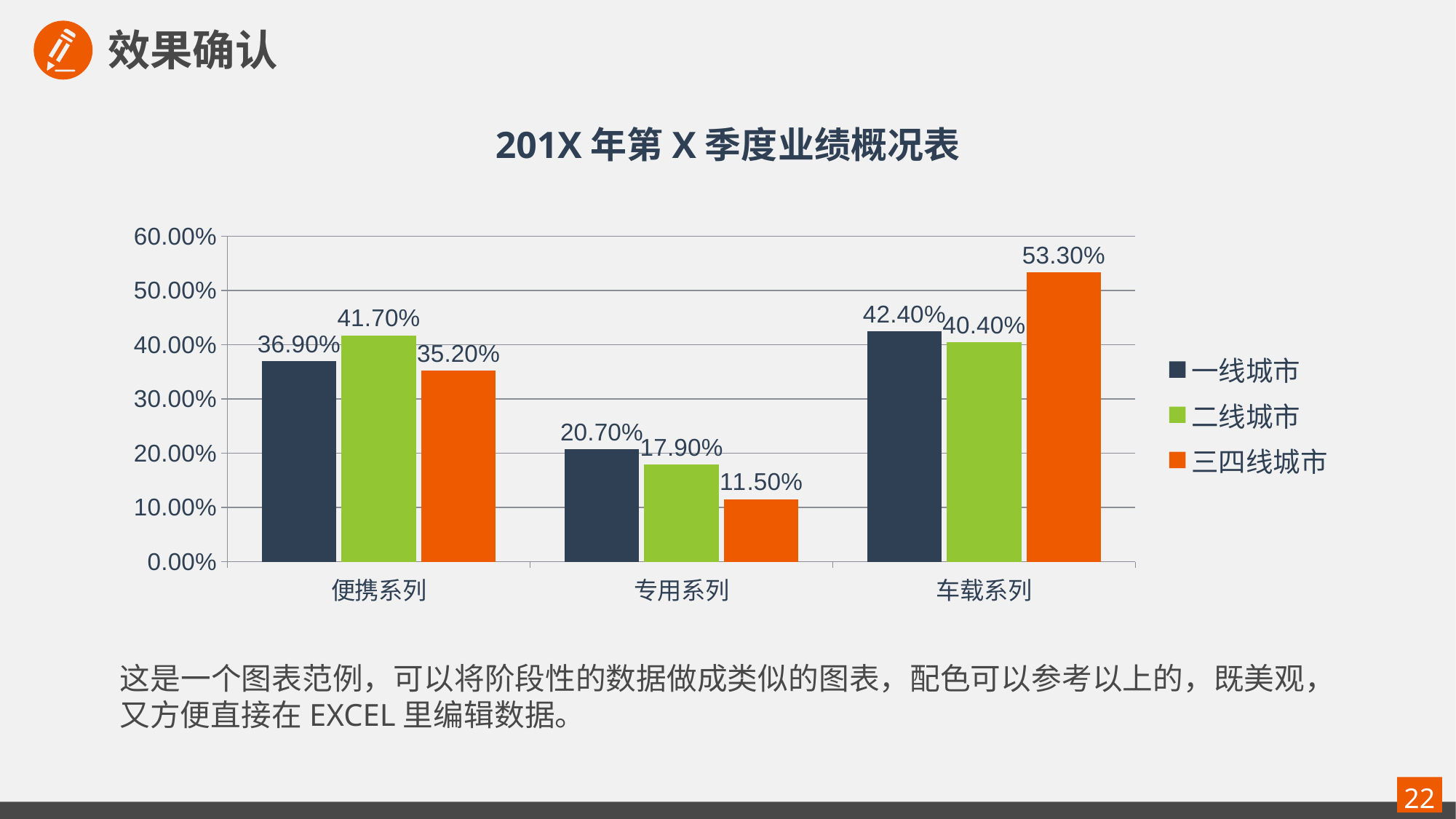
Which series has the highest value in the 车载系列 category? 三四线城市 What is the value for 一线城市 in the 便携系列 category? 36.90% What is the title of the chart? 201X 年第 X 季度业绩概况表 What is the difference between the 一线城市 and 三四线城市 values in the 专用系列 category? 9.20% What is the value for 三四线城市 in the 车载系列 category? 53.30% How many series does the legend list? 3 Which colour represents 二线城市 in the legend? Green How many categories are shown on the x axis? 3 What is the value for 二线城市 in the 专用系列 category? 17.90% Which is larger: the 二线城市 value for 便携系列 or the 二线城市 value for 车载系列? 便携系列 Which category has the lowest value for 三四线城市? 专用系列 What kind of chart is shown on the slide? Bar chart